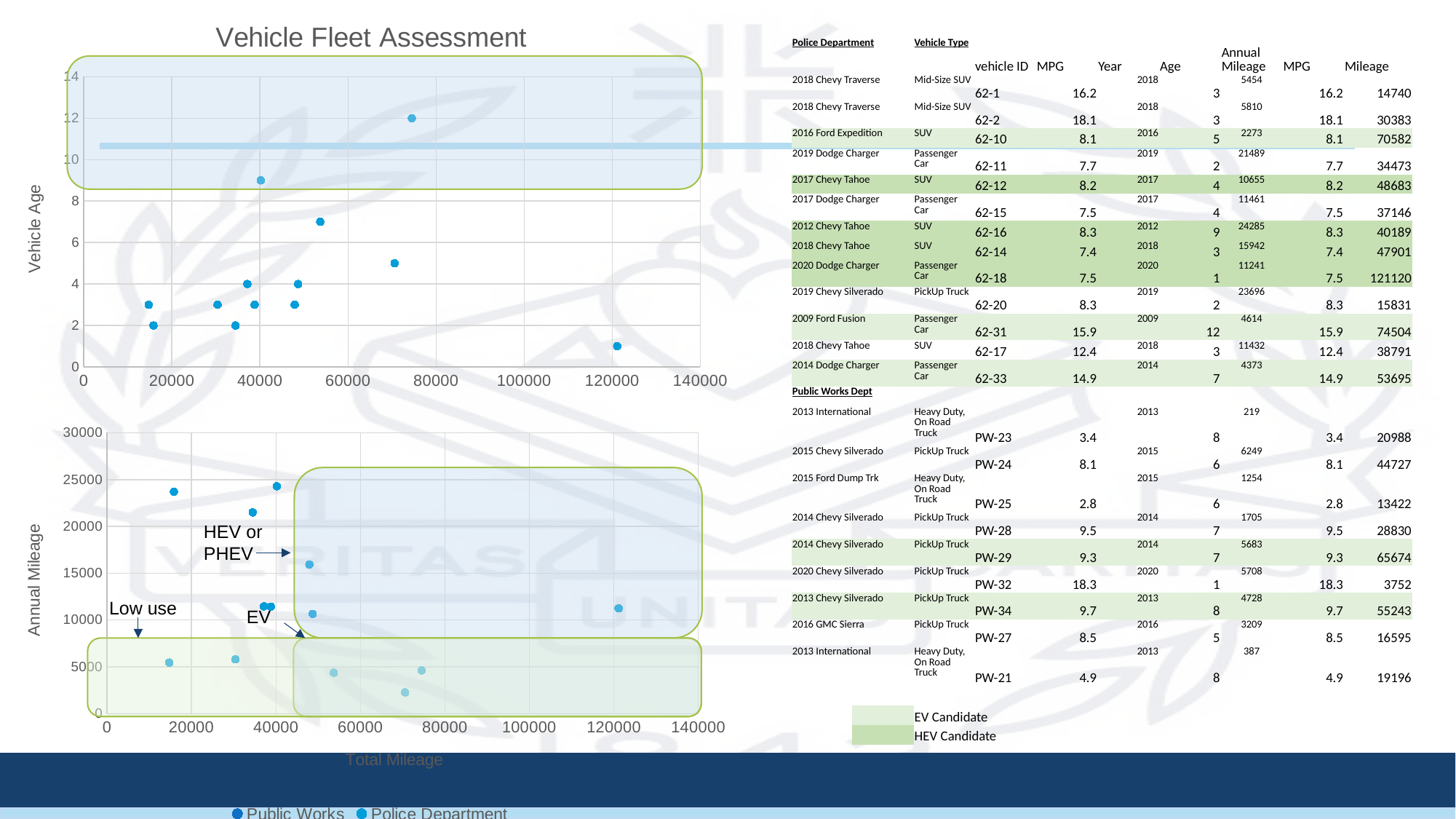
What is the title of the top chart? Vehicle Fleet Assessment What type of chart is the top chart titled 'Vehicle Fleet Assessment'? scatter chart What type of chart is the bottom chart on the slide? scatter chart In the bottom chart, which point has the higher annual mileage: the one near 40000 total mileage or the one near 70000 total mileage? the one near 40000 total mileage How many series does the legend at the bottom of the slide list? 2 In the top chart, is the vehicle age of the point near 74000 total mileage greater or less than 10? greater In the top chart, is the vehicle age of the point with the highest total mileage (around 120000) greater or less than 2? less In the top chart, which point has the highest vehicle age: the one near 74000 total mileage or the one near 120000 total mileage? the one near 74000 total mileage In the bottom chart, is the annual mileage of the point with the highest total mileage (around 120000) greater or less than 10000? greater What is the y-axis title of the top chart? Vehicle Age